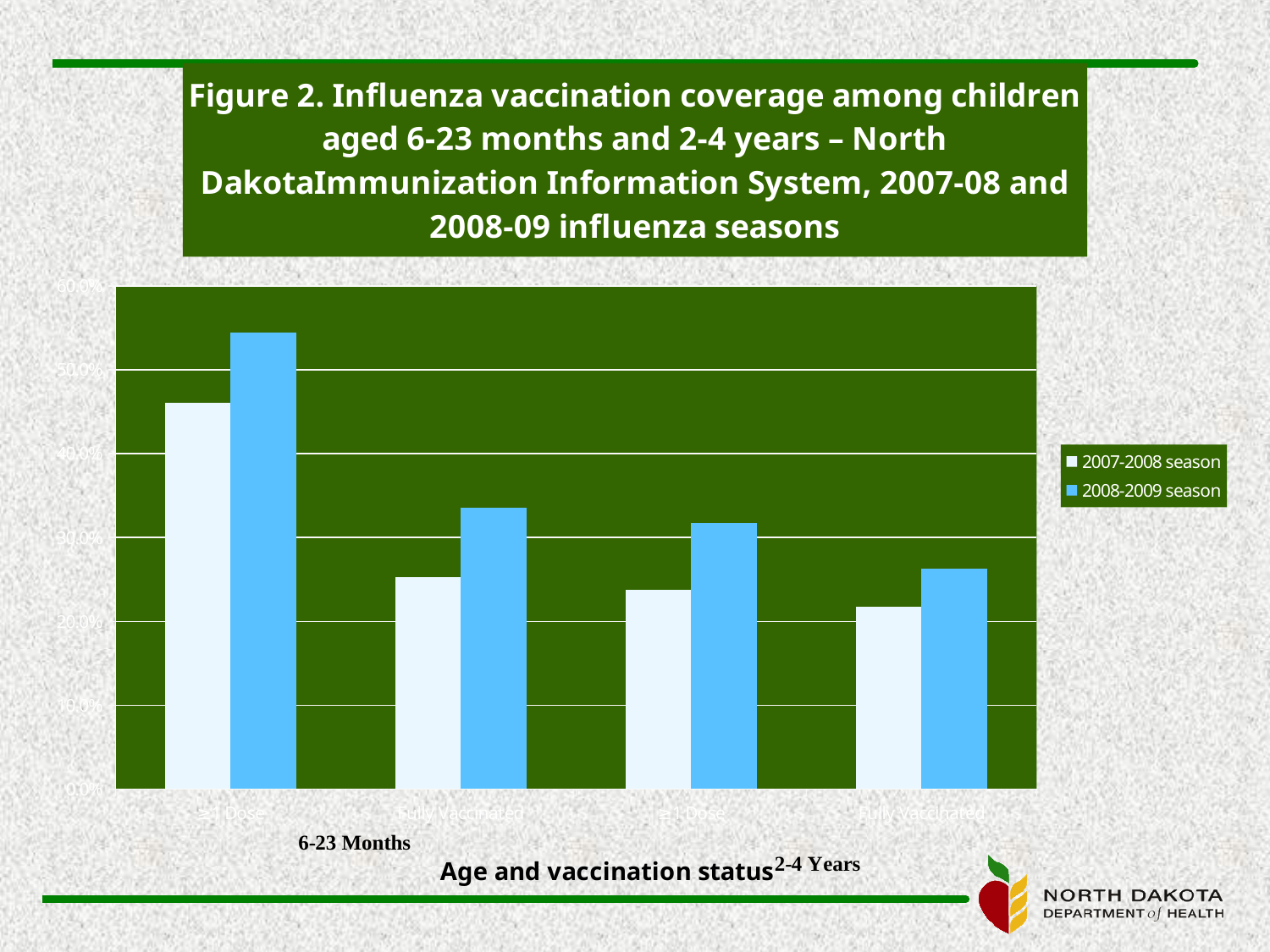
How many category groups of bars are plotted along the x axis? 4 Do the 2007-2008 season bars rise or fall moving from left to right across the x axis? fall Is the 2008-2009 season value in the leftmost group (6-23 Months, ≥1 Dose) greater or less than 50.0%? greater Is the 2007-2008 season value in the rightmost group (2-4 Years, Fully vaccinated) greater or less than 30.0%? less How many series does the legend list? 2 Which bar is the tallest in the chart? 2008-2009 season bar in the leftmost group (6-23 Months, ≥1 Dose) Is the 2007-2008 season value in the leftmost group (6-23 Months, ≥1 Dose) greater or less than 50.0%? less What kind of chart is shown on the slide? bar chart What is the title of the x axis? Age and vaccination status What are the two series named in the legend? 2007-2008 season and 2008-2009 season In every category group, which series has the taller bar? 2008-2009 season